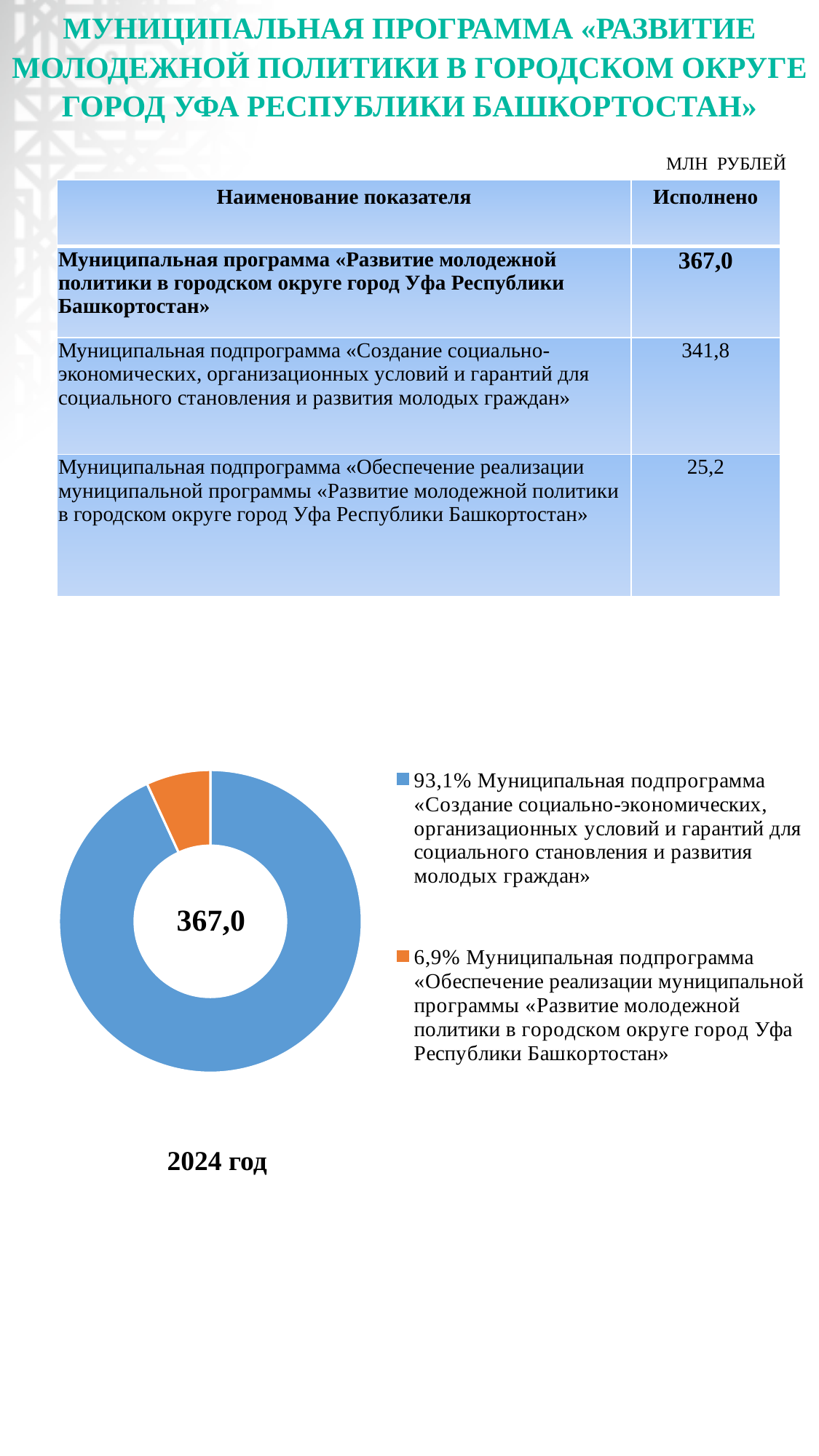
What share of the doughnut chart is taken by the subprogramme «Обеспечение реализации муниципальной программы «Развитие молодежной политики в городском округе город Уфа Республики Башкортостан»? 6,9% What share of the doughnut chart is taken by the subprogramme «Создание социально-экономических, организационных условий и гарантий для социального становления и развития молодых граждан»? 93,1% What colour is the slice for the subprogramme «Обеспечение реализации муниципальной программы...» in the doughnut chart? orange How many slices does the doughnut chart have? 2 Which is larger in the doughnut chart: the share of the subprogramme «Создание социально-экономических...» or the share of the subprogramme «Обеспечение реализации муниципальной программы...»? Муниципальная подпрограмма «Создание социально-экономических, организационных условий и гарантий для социального становления и развития молодых граждан» Which slice of the doughnut chart is the smallest? Муниципальная подпрограмма «Обеспечение реализации муниципальной программы «Развитие молодежной политики в городском округе город Уфа Республики Башкортостан» By how many percentage points does the 93,1% slice exceed the 6,9% slice in the doughnut chart? 86,2 What kind of chart is shown on the slide? doughnut chart Which year is labelled under the doughnut chart? 2024 год Which slice of the doughnut chart is the largest? Муниципальная подпрограмма «Создание социально-экономических, организационных условий и гарантий для социального становления и развития молодых граждан» How many entries does the legend of the doughnut chart list? 2 What value is printed in the centre of the doughnut chart? 367,0